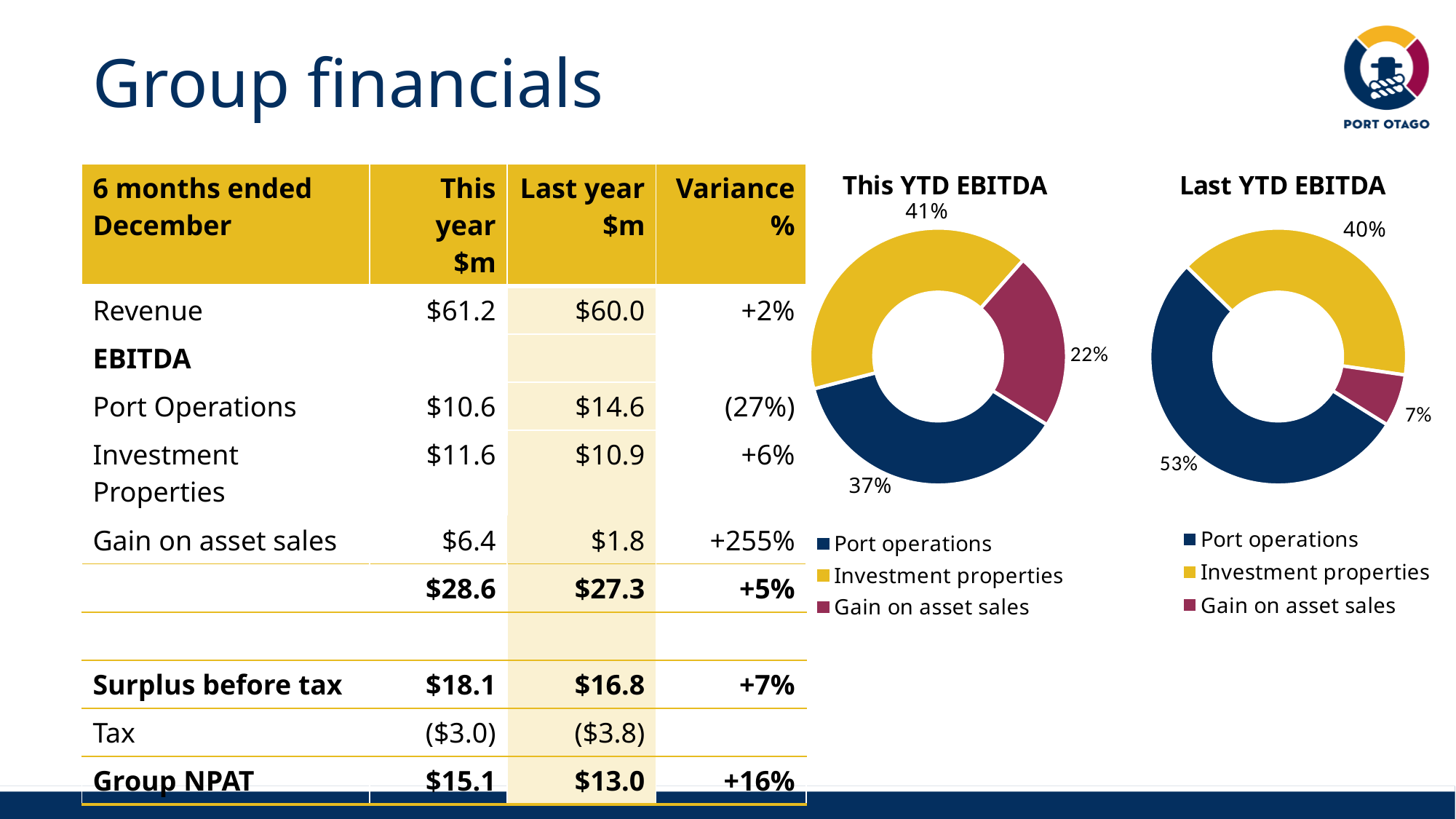
In the 'Last YTD EBITDA' chart, what share does Gain on asset sales have? 7% How many segments does the 'This YTD EBITDA' chart have? 3 In the 'This YTD EBITDA' chart, which is larger: Port operations or Gain on asset sales? Port operations In the 'This YTD EBITDA' chart, what share does Investment properties have? 41% In the 'Last YTD EBITDA' chart, what colour represents Port operations? Dark blue In the 'This YTD EBITDA' chart, what share does Gain on asset sales have? 22% How many entries does the legend of the 'Last YTD EBITDA' chart list? 3 What type of chart is 'This YTD EBITDA'? Donut (pie) chart In the 'Last YTD EBITDA' chart, what share does Port operations have? 53% In the 'Last YTD EBITDA' chart, what is the difference in percentage points between Port operations and Investment properties? 13 In the 'This YTD EBITDA' chart, which segment has the largest share? Investment properties In the 'Last YTD EBITDA' chart, which segment has the smallest share? Gain on asset sales